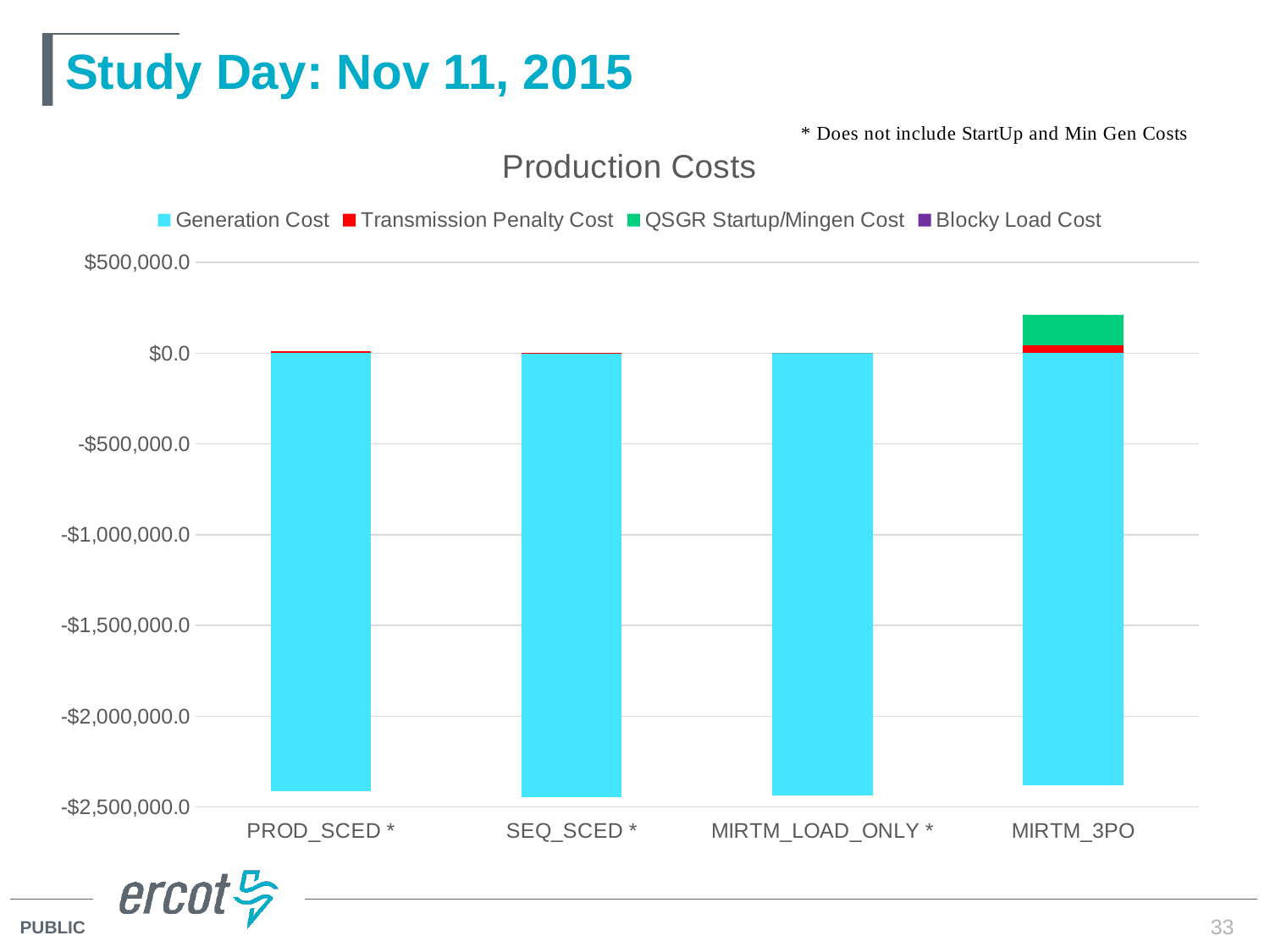
Which category has the largest QSGR Startup/Mingen Cost segment? MIRTM_3PO Is the Generation Cost value for PROD_SCED * greater or less than -$2,000,000.0? less What is the lowest value labelled on the chart's y axis? -$2,500,000.0 How many categories are shown on the x axis of the chart? 4 What is the title of the chart? Production Costs Is the QSGR Startup/Mingen Cost value for MIRTM_3PO greater or less than $500,000.0? less What kind of chart is shown on the slide? Stacked bar chart Which category has the largest Transmission Penalty Cost segment? MIRTM_3PO How many series does the chart's legend list? 4 Which series is shown in green in the chart's legend? QSGR Startup/Mingen Cost Is the QSGR Startup/Mingen Cost value for MIRTM_3PO greater or less than $0.0? greater